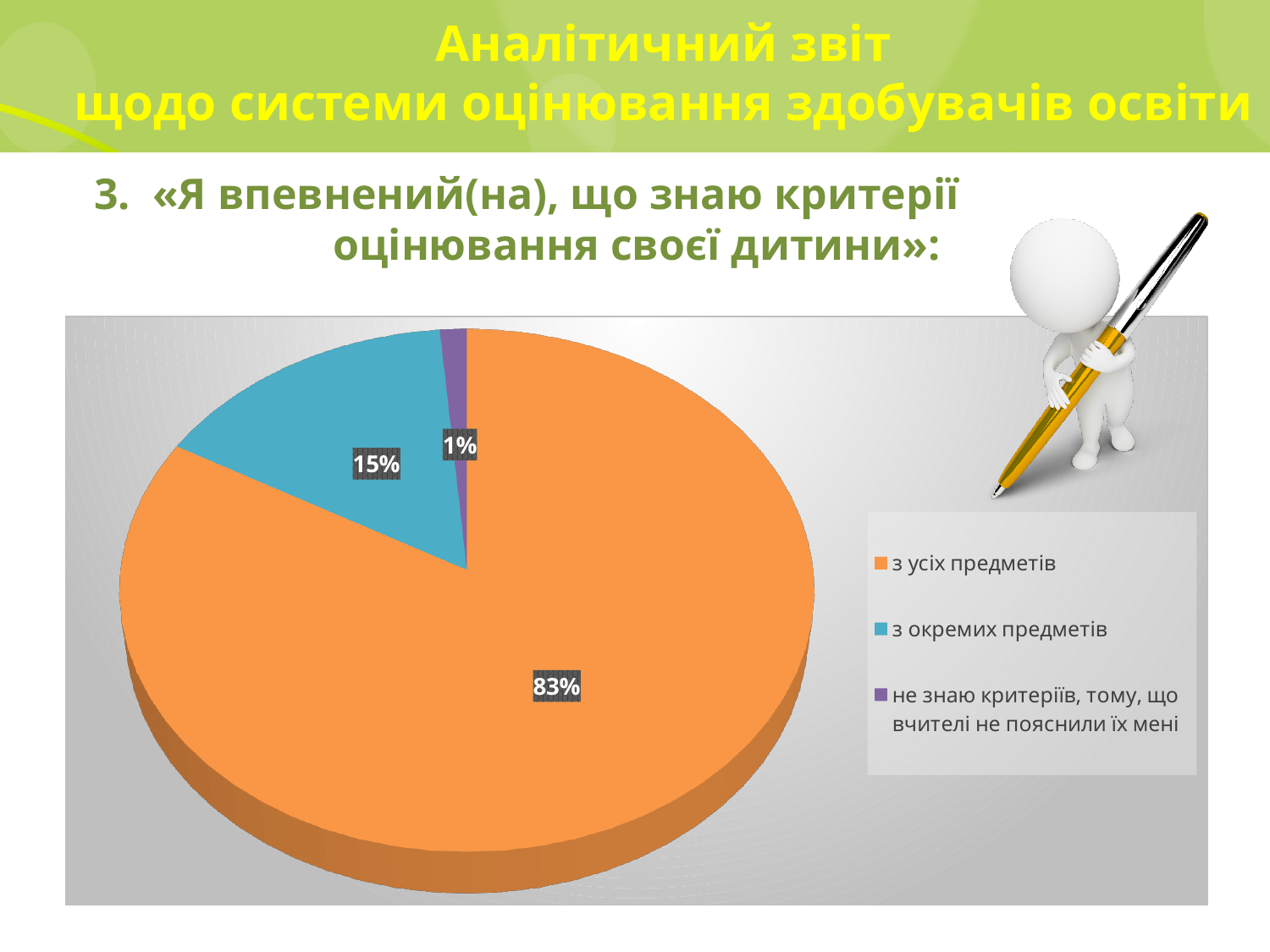
What colour is the slice for "з окремих предметів"? blue Which category has the smallest slice of the pie? не знаю критеріїв, тому, що вчителі не пояснили їх мені How many entries does the legend list? 3 What share of the pie does "з усіх предметів" have? 83% Which is larger: the share for "з окремих предметів" or the share for "не знаю критеріїв, тому, що вчителі не пояснили їх мені"? з окремих предметів What colour is the slice for "з усіх предметів"? orange What is the difference between the shares for "з усіх предметів" and "з окремих предметів"? 68% What kind of chart is shown on the slide? pie chart How many categories does the pie chart have? 3 Which category has the largest slice of the pie? з усіх предметів What share of the pie does "не знаю критеріїв, тому, що вчителі не пояснили їх мені" have? 1% What share of the pie does "з окремих предметів" have? 15%